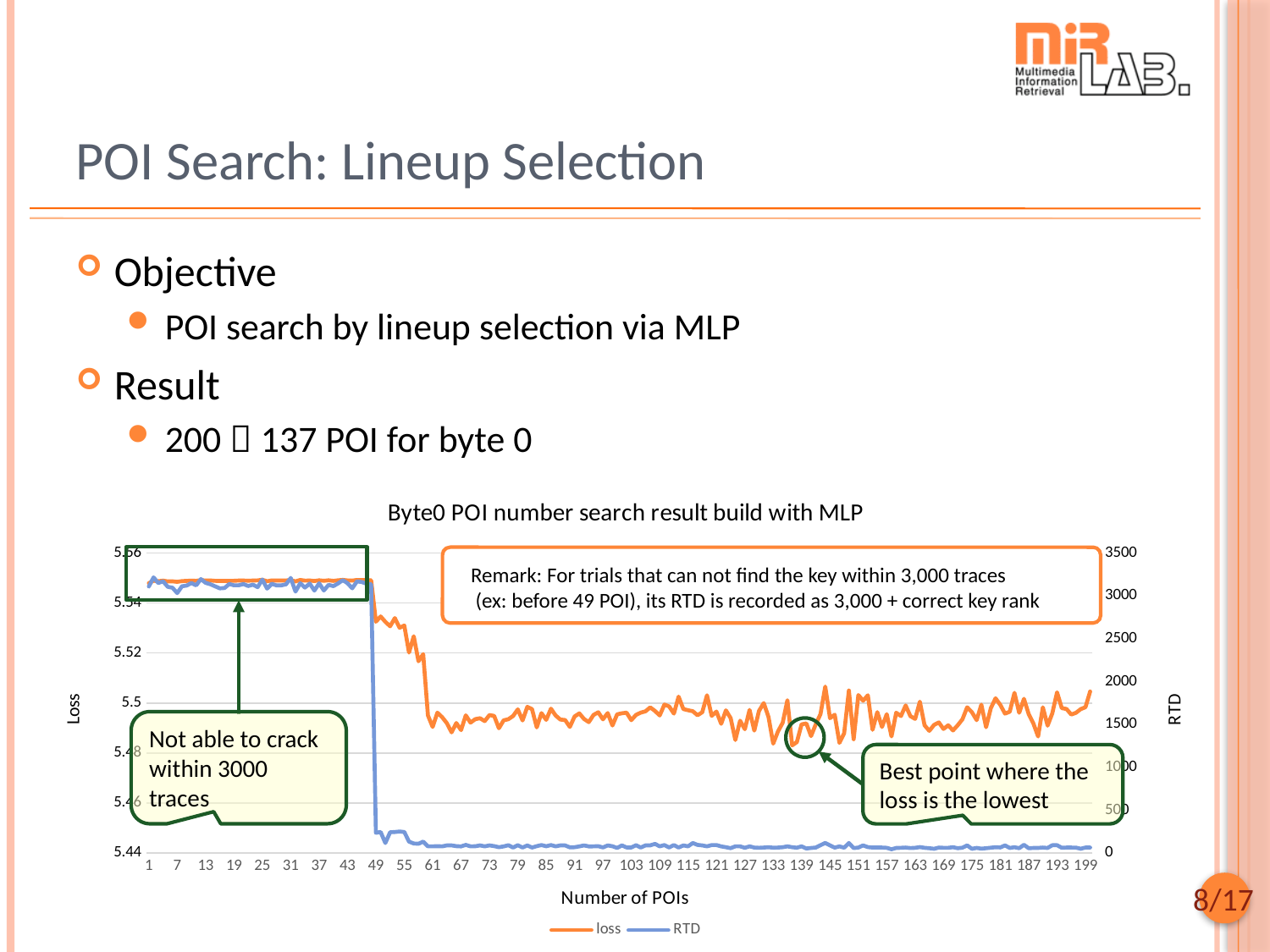
What is the title of the chart? Byte0 POI number search result build with MLP Is the loss value at 137 POIs greater or less than 5.5? less Is the loss value at 25 POIs greater or less than 5.54? greater Is the RTD value at 1 POI greater or less than 2500? greater What kind of chart is shown on the slide? line chart How many series does the chart's legend list? 2 Overall, does the RTD series rise or fall as the number of POIs increases? fall Which is larger, the loss value at 25 POIs or the loss value at 100 POIs? 25 POIs What are the two series named in the legend? loss and RTD Which is larger, the RTD value at 25 POIs or the RTD value at 100 POIs? 25 POIs